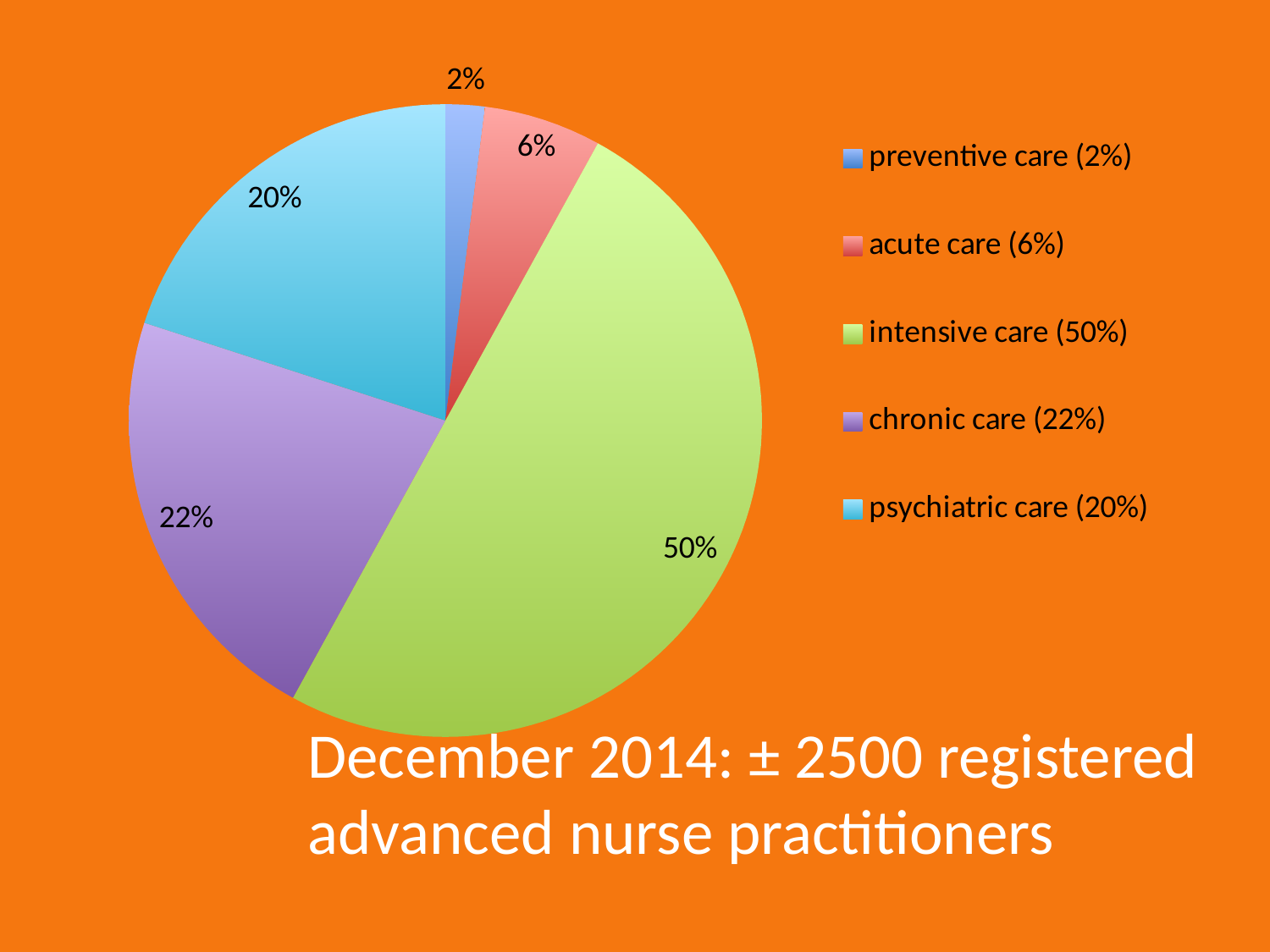
Which is larger, the share for chronic care or the share for psychiatric care? chronic care What kind of chart is shown on the slide? pie chart What is the difference in percentage points between intensive care and chronic care? 28 What is the difference in percentage points between acute care and preventive care? 4 Which category has the smallest slice of the pie? preventive care Which category has the largest slice of the pie? intensive care What share of the pie does intensive care represent? 50% What share of the pie does acute care represent? 6% What share of the pie does psychiatric care represent? 20% What share of the pie does chronic care represent? 22% What colour is the slice for intensive care? green How many categories are shown in the pie chart? 5